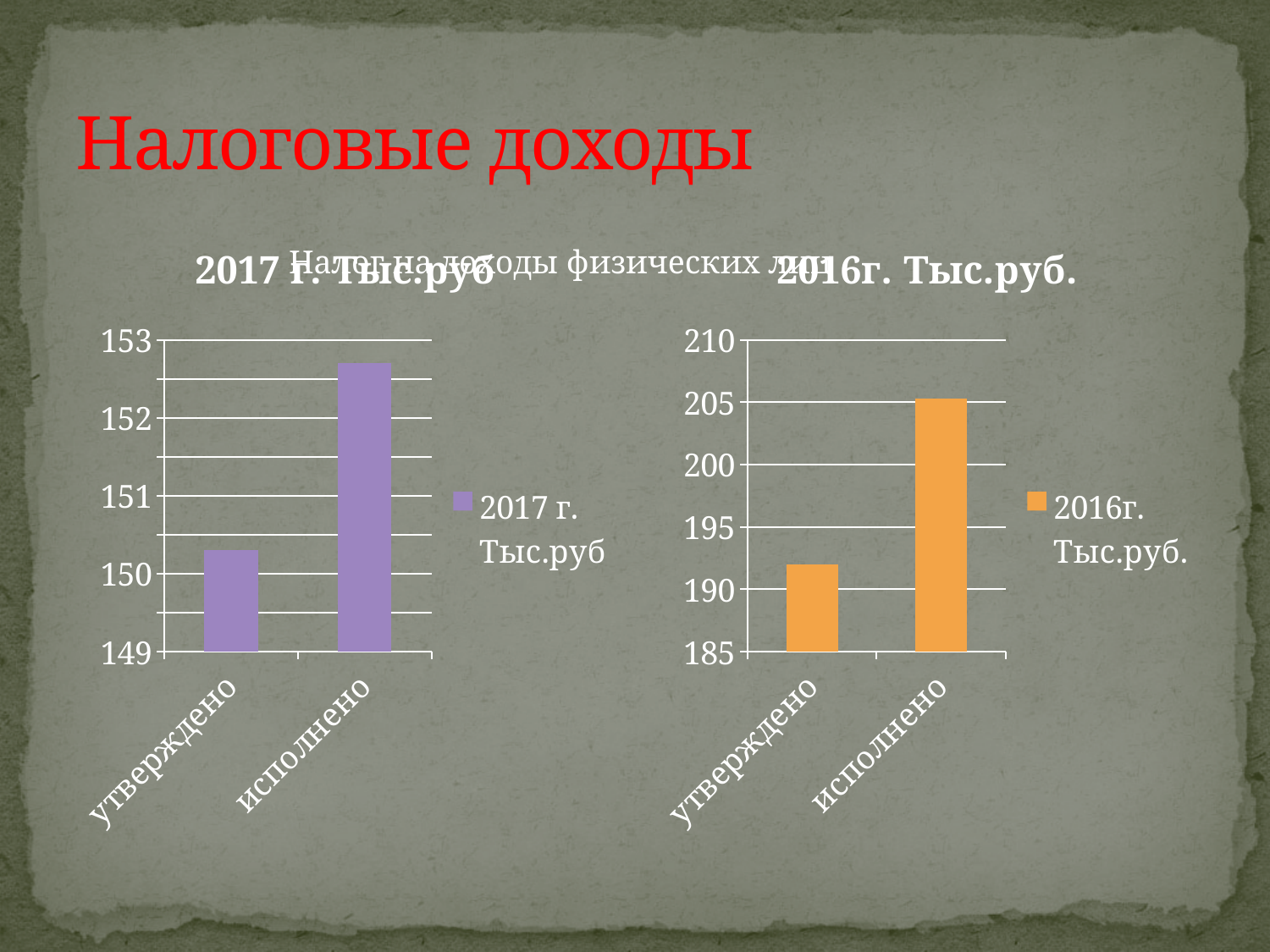
In the chart titled "2017 г. Тыс.руб" (left), is the value for исполнено greater or less than 152? greater In the chart titled "2017 г. Тыс.руб" (left), do the values rise or fall from утверждено to исполнено? rise What kind of chart is the chart titled "2017 г. Тыс.руб" (left)? bar chart In the chart titled "2017 г. Тыс.руб" (left), which category has the higher value? исполнено In the chart titled "2016г. Тыс.руб." (right), is the value for исполнено greater or less than 200? greater How many categories are shown in the chart titled "2016г. Тыс.руб." (right)? 2 In the chart titled "2016г. Тыс.руб." (right), which category has the higher value? исполнено In the chart titled "2017 г. Тыс.руб" (left), which category has the lower value? утверждено How many series does the legend of the chart titled "2016г. Тыс.руб." (right) list? 1 In the chart titled "2016г. Тыс.руб." (right), is the value for утверждено greater or less than 195? less What colour are the bars in the chart titled "2016г. Тыс.руб." (right)? orange